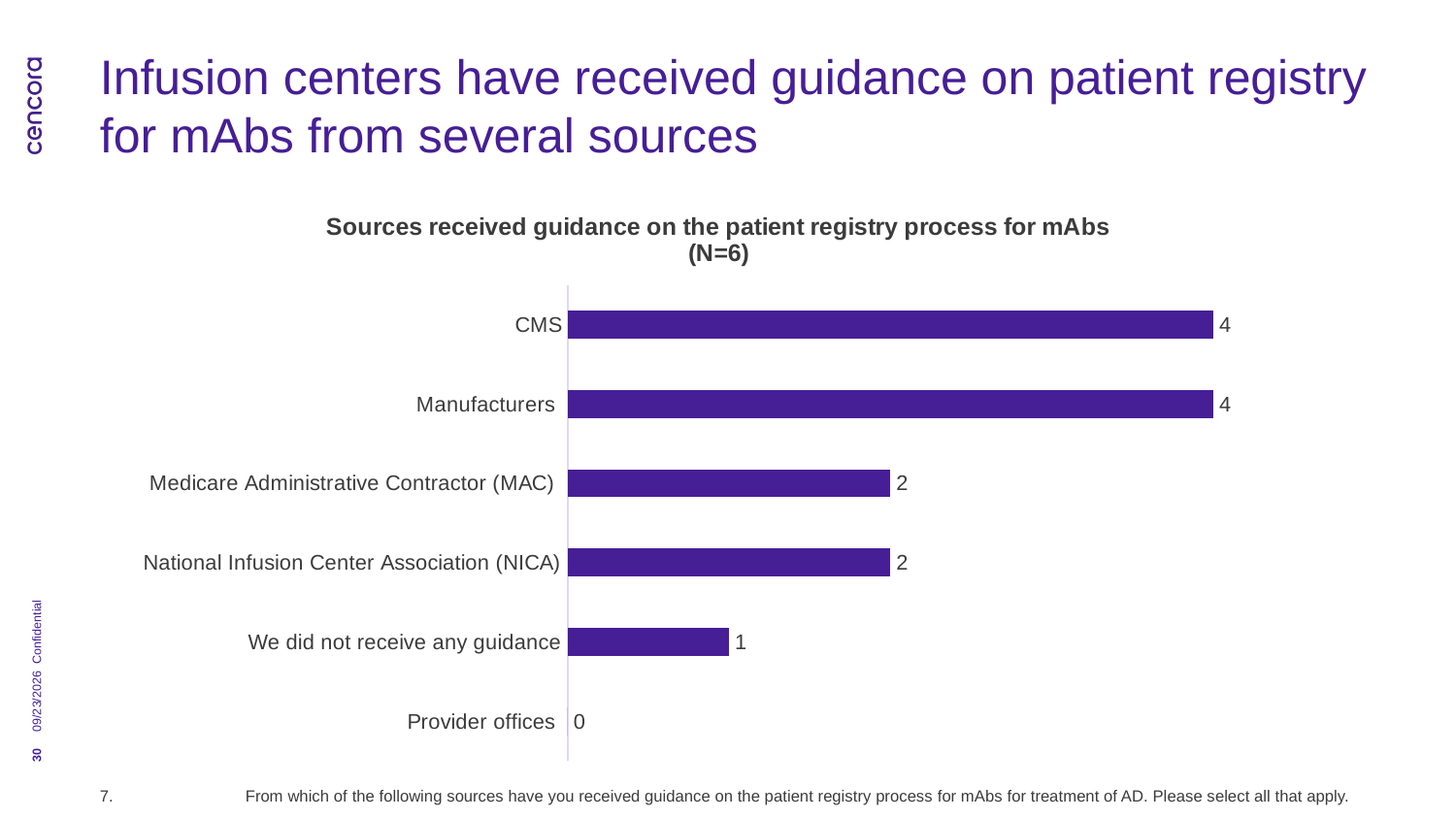
Which category has the lowest value? Provider offices What is the value for 'We did not receive any guidance'? 1 What is the sample size (N) stated in the chart title? N=6 How many categories are shown in the chart? 6 What is the value for Medicare Administrative Contractor (MAC)? 2 What is the difference between the values for CMS and Provider offices? 4 What is the title of the chart? Sources received guidance on the patient registry process for mAbs (N=6) What is the value for CMS? 4 What is the difference between the values for Manufacturers and National Infusion Center Association (NICA)? 2 What kind of chart is shown on the slide? Bar chart Which is larger, the value for CMS or the value for 'We did not receive any guidance'? CMS What is the value for Provider offices? 0